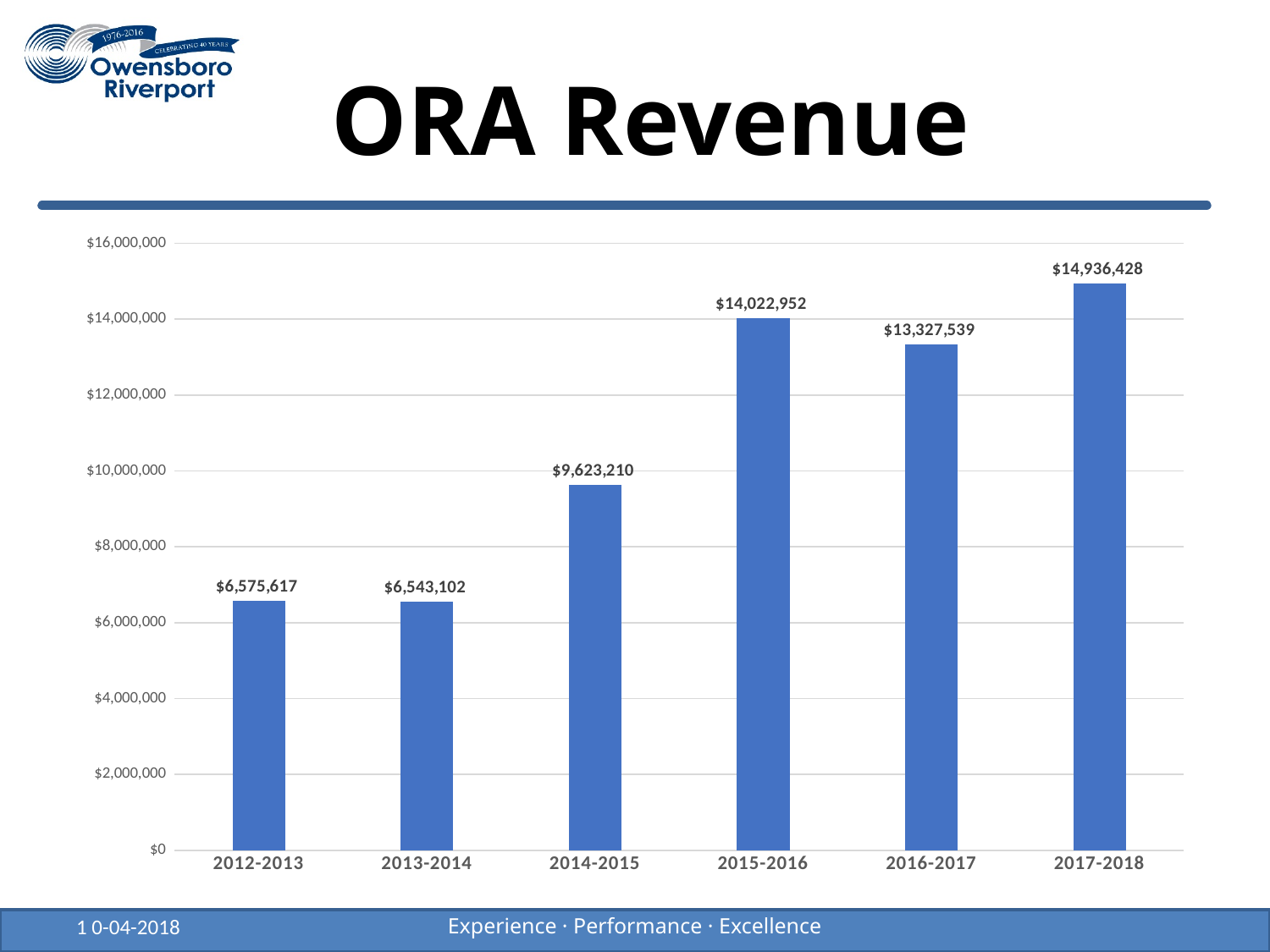
Which fiscal year has the lowest ORA Revenue? 2013-2014 What is the difference in ORA Revenue between 2015-2016 and 2016-2017? $695,413 What kind of chart is used to show ORA Revenue? bar chart What is the ORA Revenue value for 2015-2016? $14,022,952 Is the ORA Revenue for 2014-2015 greater or less than $10,000,000? less What is the difference in ORA Revenue between 2017-2018 and 2015-2016? $913,476 Which fiscal year has the highest ORA Revenue? 2017-2018 Which year has higher ORA Revenue, 2014-2015 or 2016-2017? 2016-2017 What is the ORA Revenue value for 2012-2013? $6,575,617 Overall, does ORA Revenue rise or fall from 2012-2013 to 2017-2018? rise What is the ORA Revenue value for 2014-2015? $9,623,210 How many fiscal years are shown on the ORA Revenue chart? 6